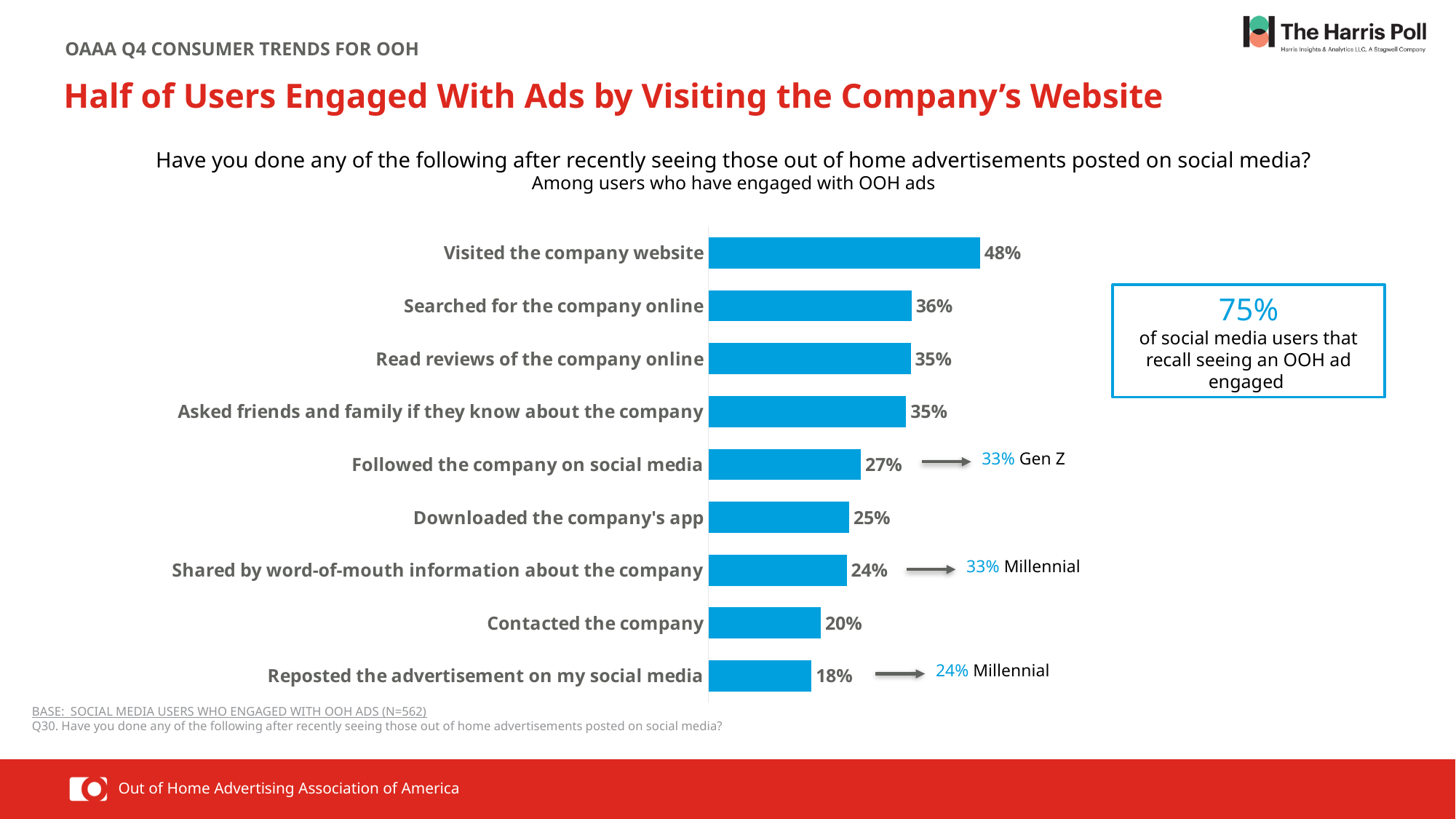
How many actions (categories) are shown in the bar chart? 9 Which is larger: the value for 'Downloaded the company's app' or the value for 'Contacted the company'? Downloaded the company's app What type of chart is used on this slide? Bar chart What is the difference in percentage points between 'Visited the company website' and 'Searched for the company online'? 12 What percentage of users contacted the company? 20% What percentage of users visited the company website after seeing OOH ads on social media? 48% What percentage of users downloaded the company's app? 25% What percentage of Millennials reposted the advertisement on their social media, according to the annotation? 24% What is the difference in percentage points between 'Followed the company on social media' and 'Reposted the advertisement on my social media'? 9 Which action has the lowest percentage in the chart? Reposted the advertisement on my social media What percentage of Gen Z followed the company on social media, according to the annotation? 33% Which action has the highest percentage in the chart? Visited the company website